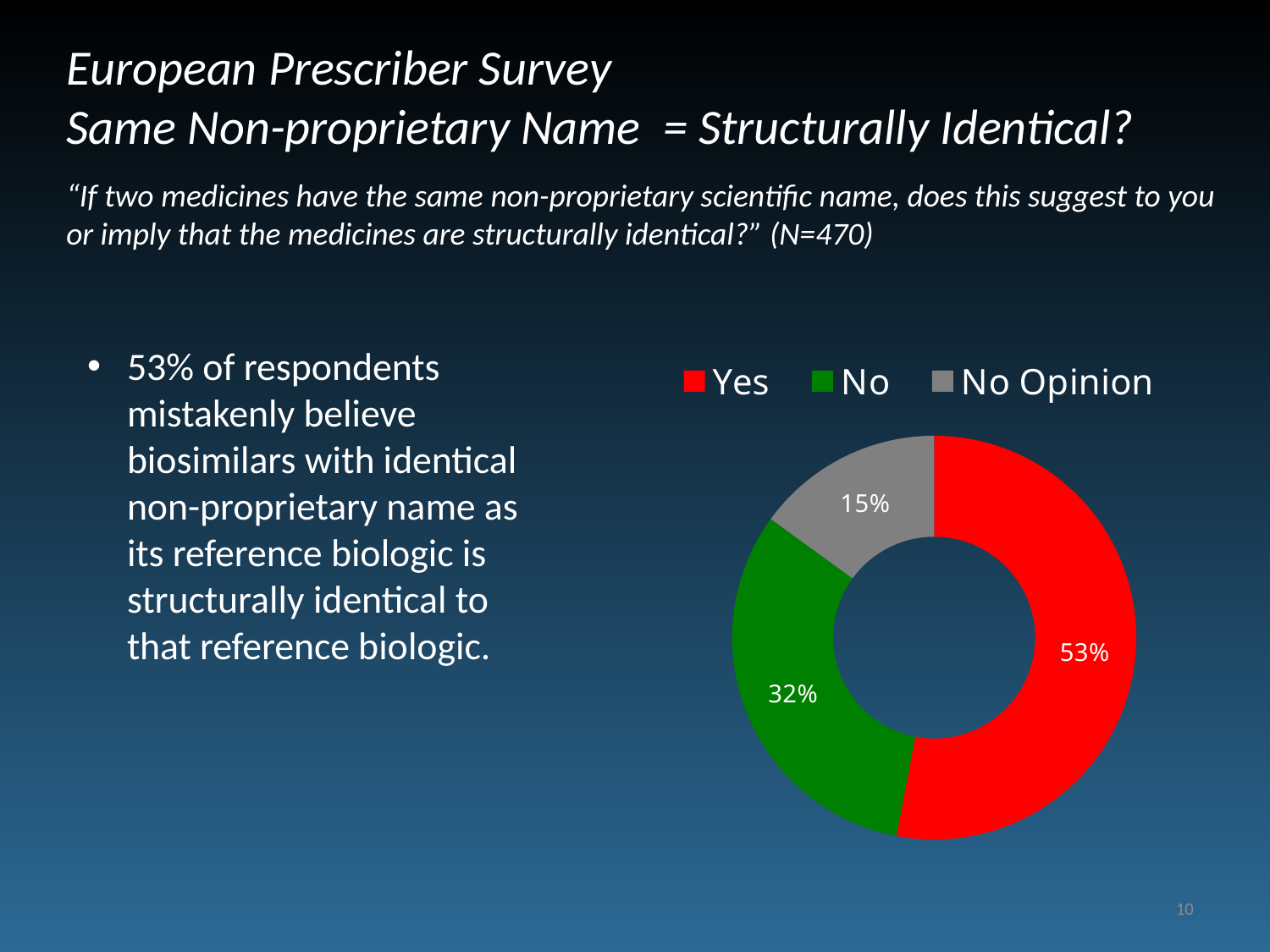
What is the difference in percentage points between the "Yes" and "No" responses? 21 What percentage of respondents answered "Yes"? 53% What is the difference in percentage points between the "No" and "No Opinion" responses? 17 What percentage of respondents answered "No"? 32% How many response categories does the chart show? 3 What percentage of respondents answered "No Opinion"? 15% Which response has the smallest share of the chart? No Opinion What kind of chart is shown on the slide? Doughnut chart Which response is larger, "No" or "No Opinion"? No Which response has the largest share of the chart? Yes What colour represents the "No Opinion" response in the chart? Grey What colour represents the "No" response in the chart? Green